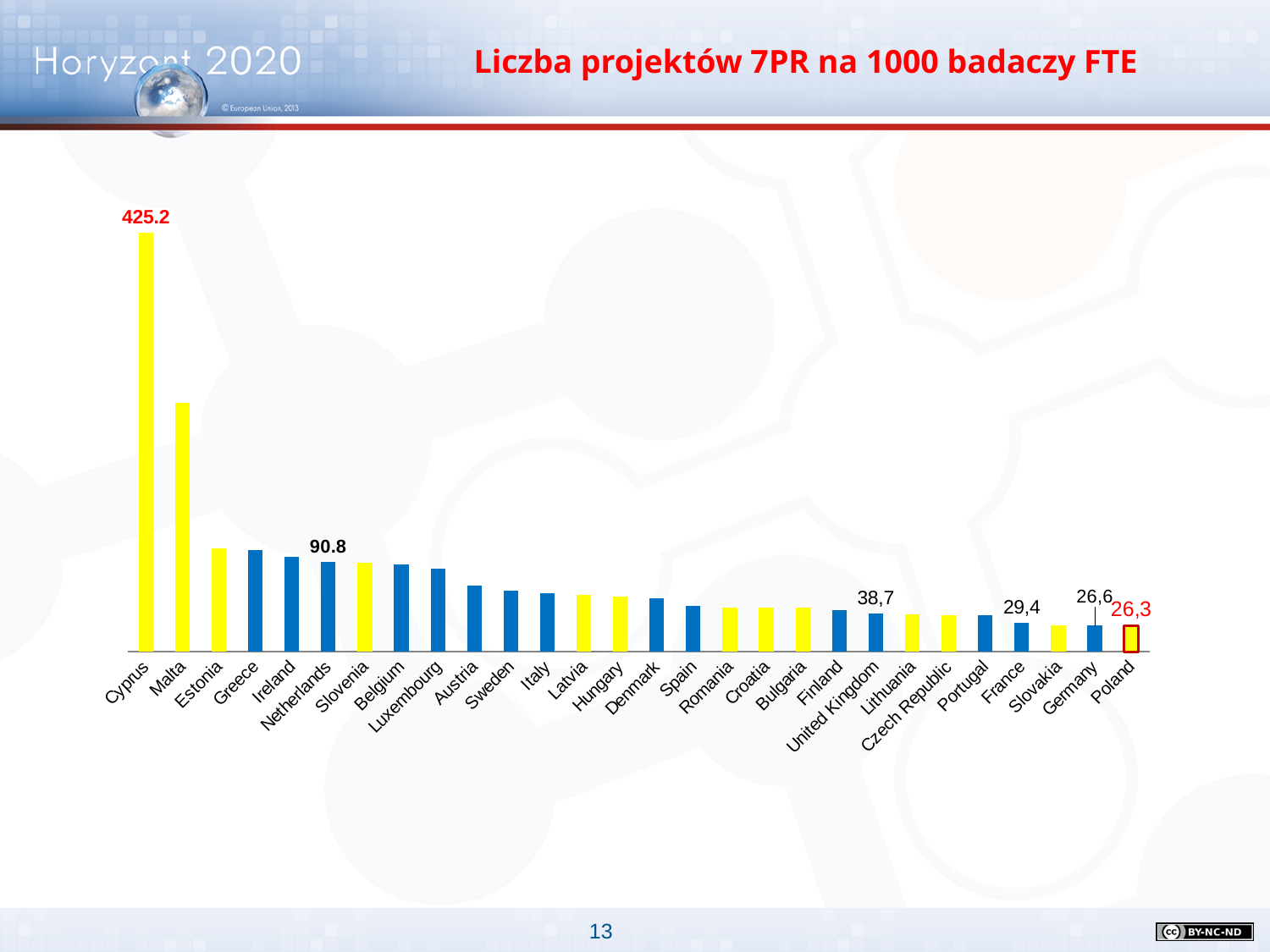
What kind of chart is shown on the slide? bar chart How many countries are shown on the chart? 28 What is the difference between the values for Cyprus and the Netherlands? 334.4 What is the value for Cyprus? 425.2 Which country has the highest value? Cyprus Do the values generally rise or fall from left to right along the x axis? fall What is the value for Poland? 26,3 What is the title of the chart? Liczba projektów 7PR na 1000 badaczy FTE Which has the larger value, Malta or Estonia? Malta What is the value for the United Kingdom? 38,7 What is the value for the Netherlands? 90.8 What is the value for France? 29,4